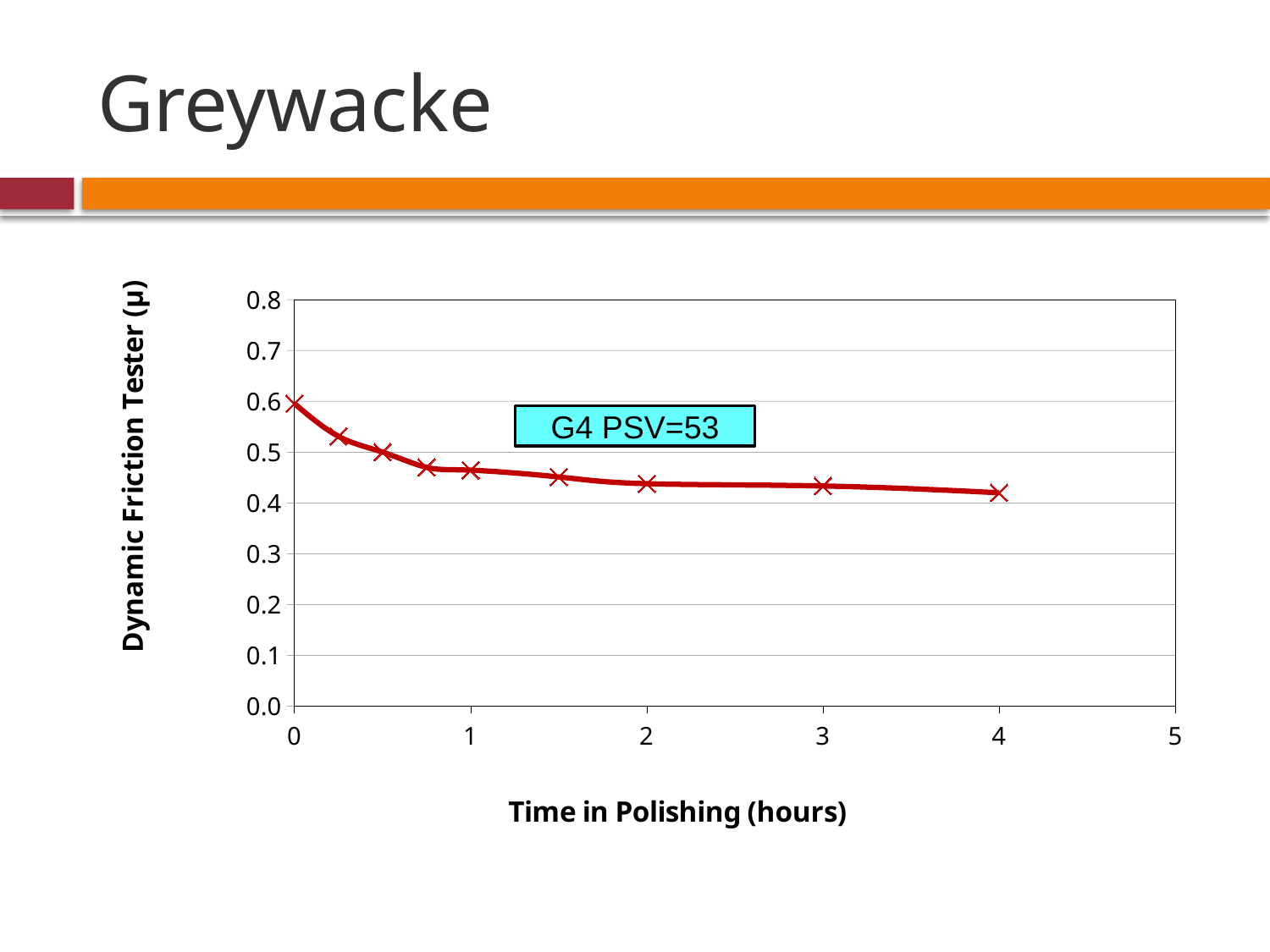
What label appears in the box on the chart? G4 PSV=53 What kind of chart is shown on the slide? line chart At which polishing time is the Dynamic Friction Tester value highest? 0 hours Which has the larger Dynamic Friction Tester value: 1 hour or 3 hours of polishing? 1 hour At which polishing time is the Dynamic Friction Tester value lowest? 4 hours Is the Dynamic Friction Tester value at 1 hour greater or less than 0.5? less Is the Dynamic Friction Tester value at 4 hours greater or less than 0.5? less How many data points are plotted on the chart? 9 Do the Dynamic Friction Tester values rise or fall as time in polishing increases? fall Is the Dynamic Friction Tester value at 2 hours greater or less than 0.4? greater What is the Dynamic Friction Tester value at 0.5 hours of polishing? 0.5